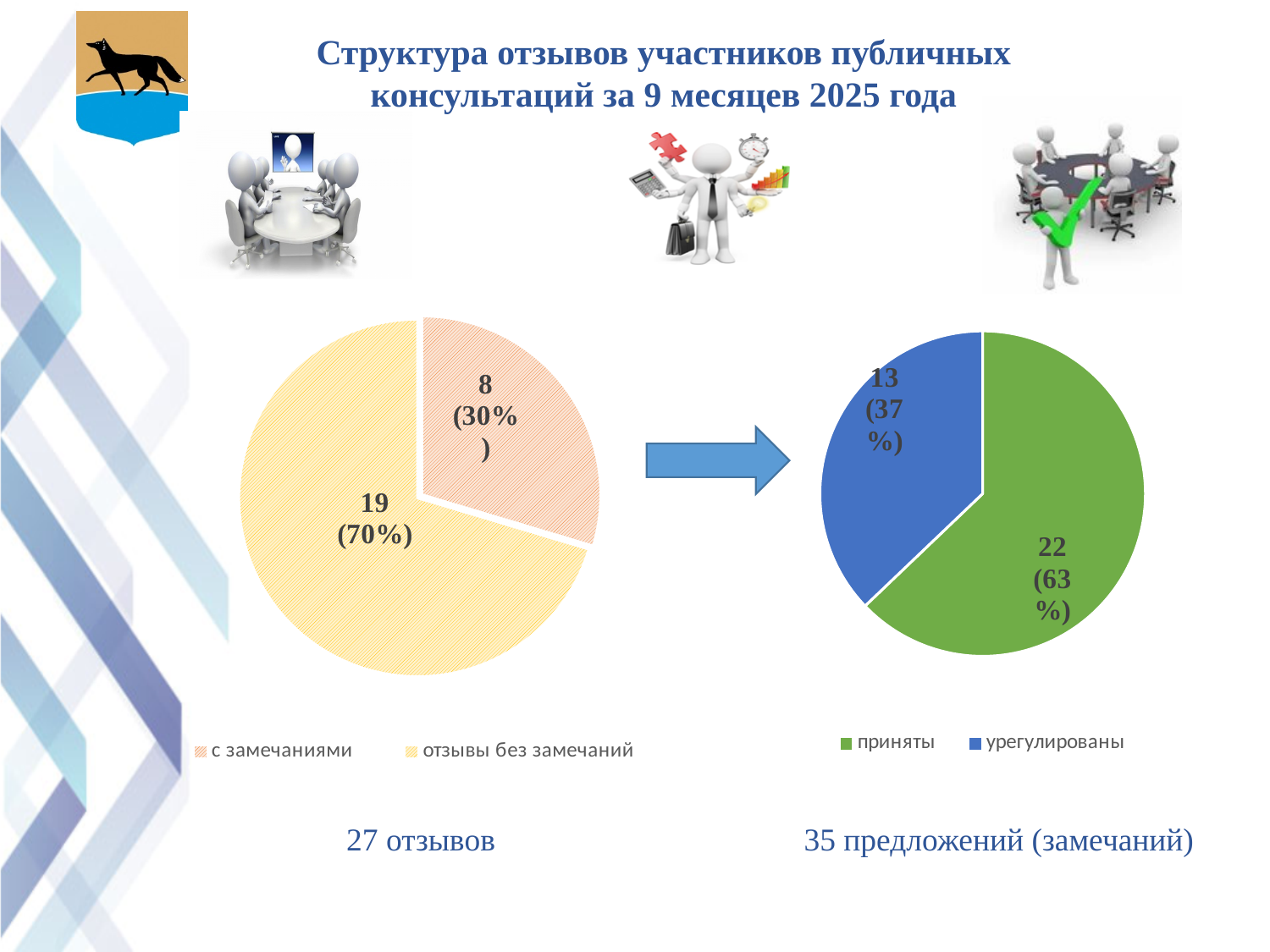
In the right pie chart, what is the difference between the values for 'приняты' and 'урегулированы'? 9 In the right pie chart, which colour represents 'приняты'? green In the right pie chart, which category has the smallest slice? урегулированы In the left pie chart, what is the value for 'с замечаниями'? 8 (30%) In the left pie chart, what share of the pie does 'с замечаниями' take? 30% In the right pie chart, what is the value for 'приняты'? 22 (63%) What type of chart is the left chart on the slide? pie chart How many categories does the legend of the left pie chart list? 2 In the left pie chart, what is the difference between the values for 'отзывы без замечаний' and 'с замечаниями'? 11 In the left pie chart, what is the value for 'отзывы без замечаний'? 19 (70%) In the left pie chart, which category has the largest slice? отзывы без замечаний In the right pie chart, what is the value for 'урегулированы'? 13 (37%)